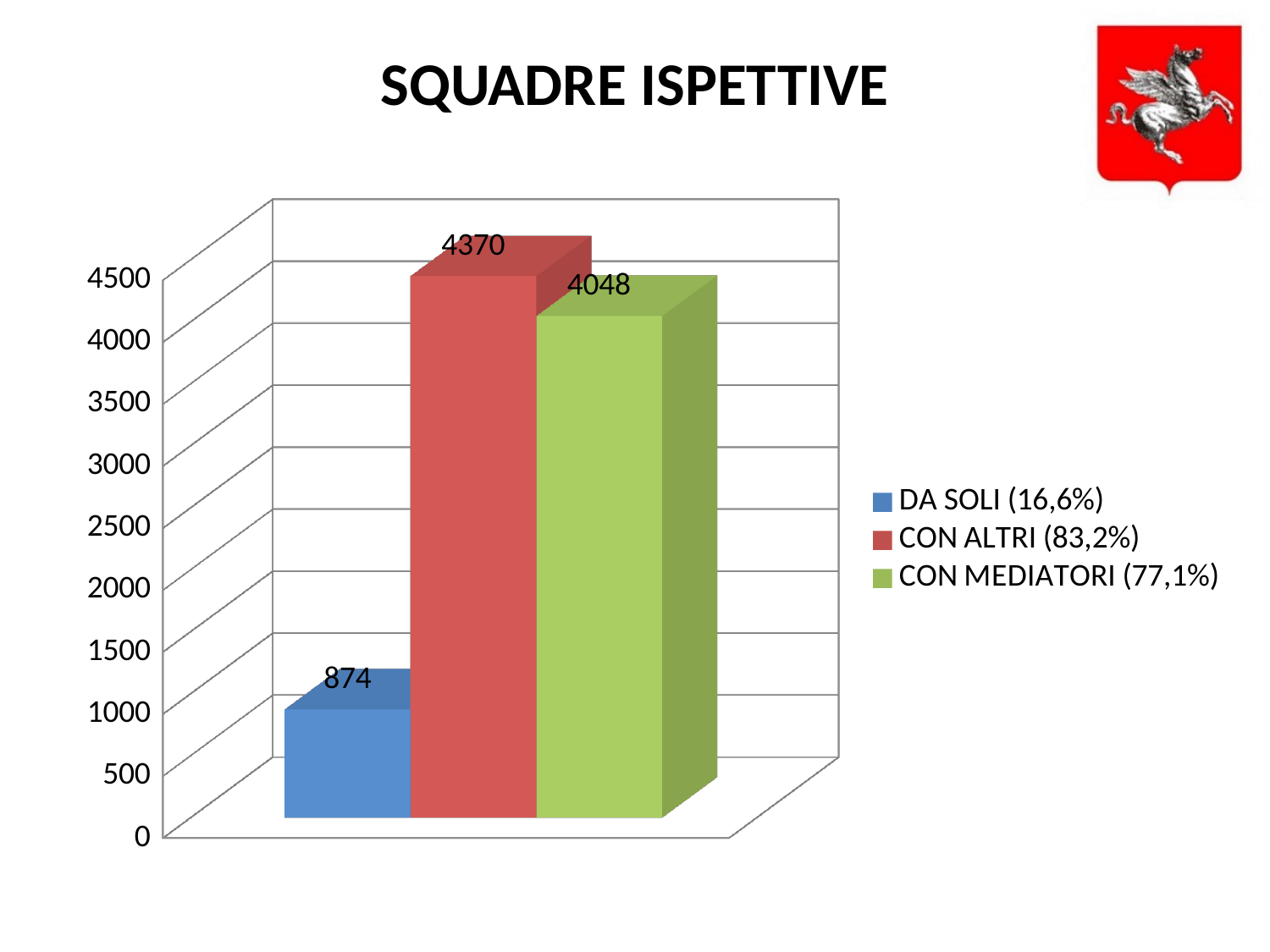
Is the value for DA SOLI greater or less than 1000? less What is the difference between the values for CON ALTRI and CON MEDIATORI? 322 What is the difference between the values for CON ALTRI and DA SOLI? 3496 What is the value for CON ALTRI? 4370 What kind of chart is shown on the slide? bar chart What is the value for CON MEDIATORI? 4048 Which series has the highest value? CON ALTRI Which series has the lowest value? DA SOLI What is the value for DA SOLI? 874 How many series does the legend list? 3 What is the title of the chart? SQUADRE ISPETTIVE Which is larger, the value for CON MEDIATORI or the value for DA SOLI? CON MEDIATORI